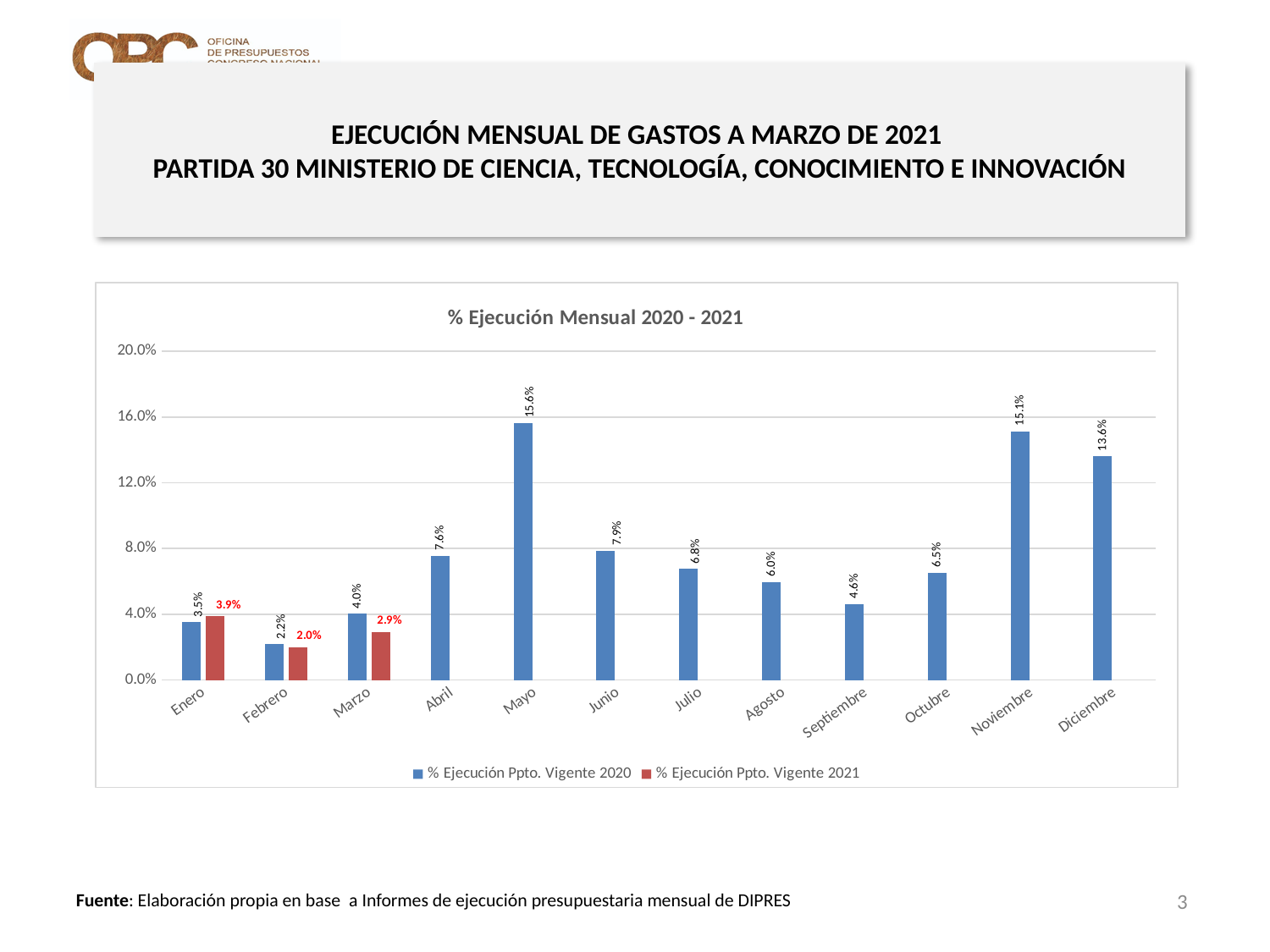
How many series does the legend list? 2 What kind of chart is shown? Bar chart What is the value for Mayo in the % Ejecución Ppto. Vigente 2020 series? 15.6% What is the title of the chart? % Ejecución Mensual 2020 - 2021 Is the value for Noviembre in the 2020 series greater or less than 12.0%? greater What is the value for Diciembre in the % Ejecución Ppto. Vigente 2020 series? 13.6% Which is larger for Marzo: the 2020 value or the 2021 value? 2020 value Which month has the lowest value in the % Ejecución Ppto. Vigente 2020 series? Febrero How many months are shown on the x axis? 12 What is the value for Marzo in the % Ejecución Ppto. Vigente 2021 series? 2.9% What is the difference between the 2021 and 2020 values for Enero? 0.4% Which month has the highest value in the % Ejecución Ppto. Vigente 2020 series? Mayo